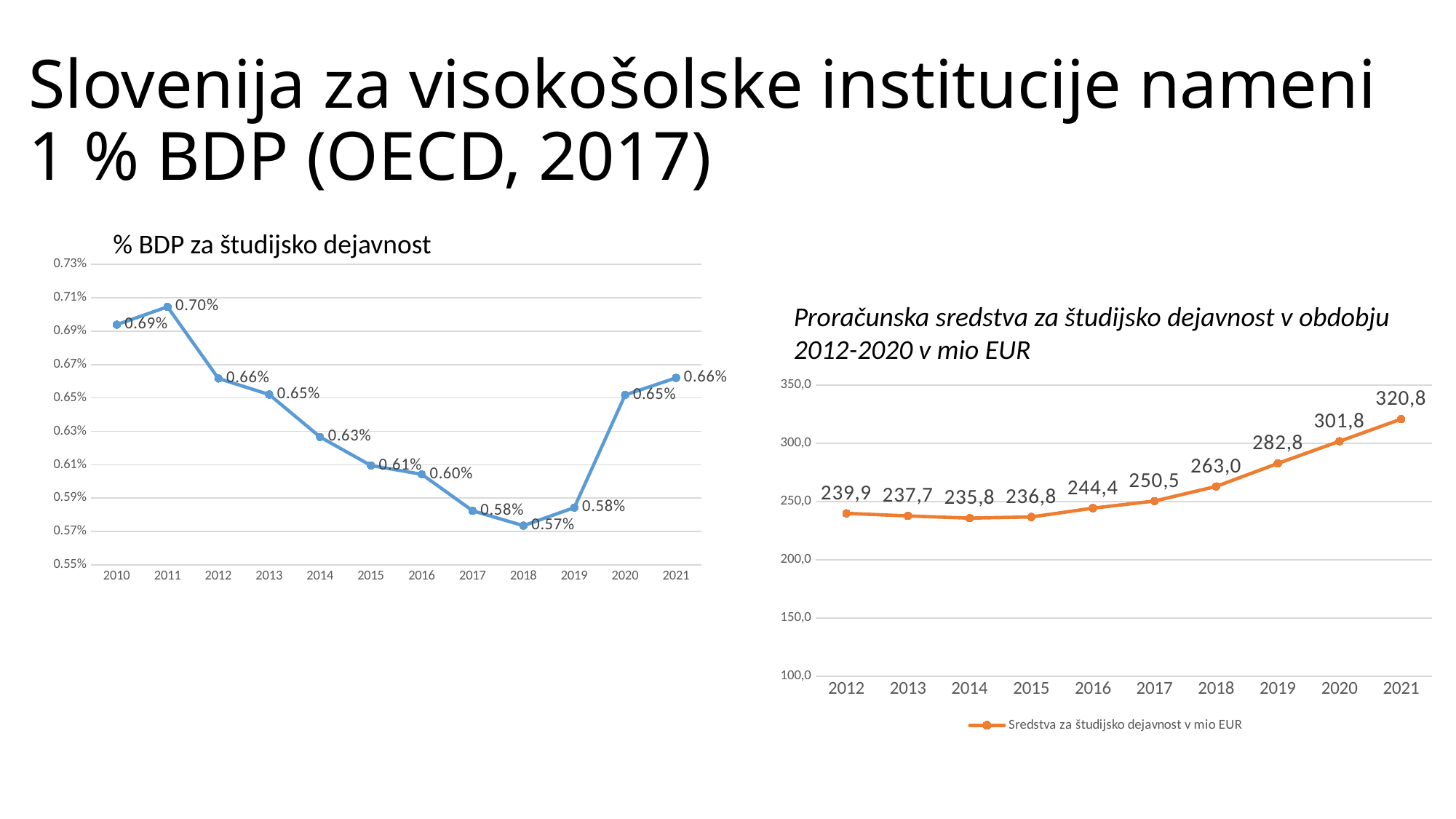
In the chart titled '% BDP za študijsko dejavnost', what is the value for 2011? 0.70% In the chart titled 'Proračunska sredstva za študijsko dejavnost v obdobju 2012-2020 v mio EUR', what is the value for 2021? 320,8 In the chart titled '% BDP za študijsko dejavnost', which year has the lowest value? 2018 In the chart titled '% BDP za študijsko dejavnost', what is the value for 2018? 0.57% In the chart titled 'Proračunska sredstva za študijsko dejavnost v obdobju 2012-2020 v mio EUR', do the values rise or fall from 2016 to 2021? Rise In the chart titled '% BDP za študijsko dejavnost', what kind of chart is shown? Line chart In the chart titled '% BDP za študijsko dejavnost', how many years are plotted on the x axis? 12 In the chart titled 'Proračunska sredstva za študijsko dejavnost v obdobju 2012-2020 v mio EUR', what is the difference between the values for 2021 and 2020? 19,0 In the chart titled '% BDP za študijsko dejavnost', which year has the highest value? 2011 In the chart titled 'Proračunska sredstva za študijsko dejavnost v obdobju 2012-2020 v mio EUR', which year has the lowest value? 2014 In the chart titled 'Proračunska sredstva za študijsko dejavnost v obdobju 2012-2020 v mio EUR', what series name does the legend show? Sredstva za študijsko dejavnost v mio EUR In the chart titled 'Proračunska sredstva za študijsko dejavnost v obdobju 2012-2020 v mio EUR', what is the value for 2014? 235,8